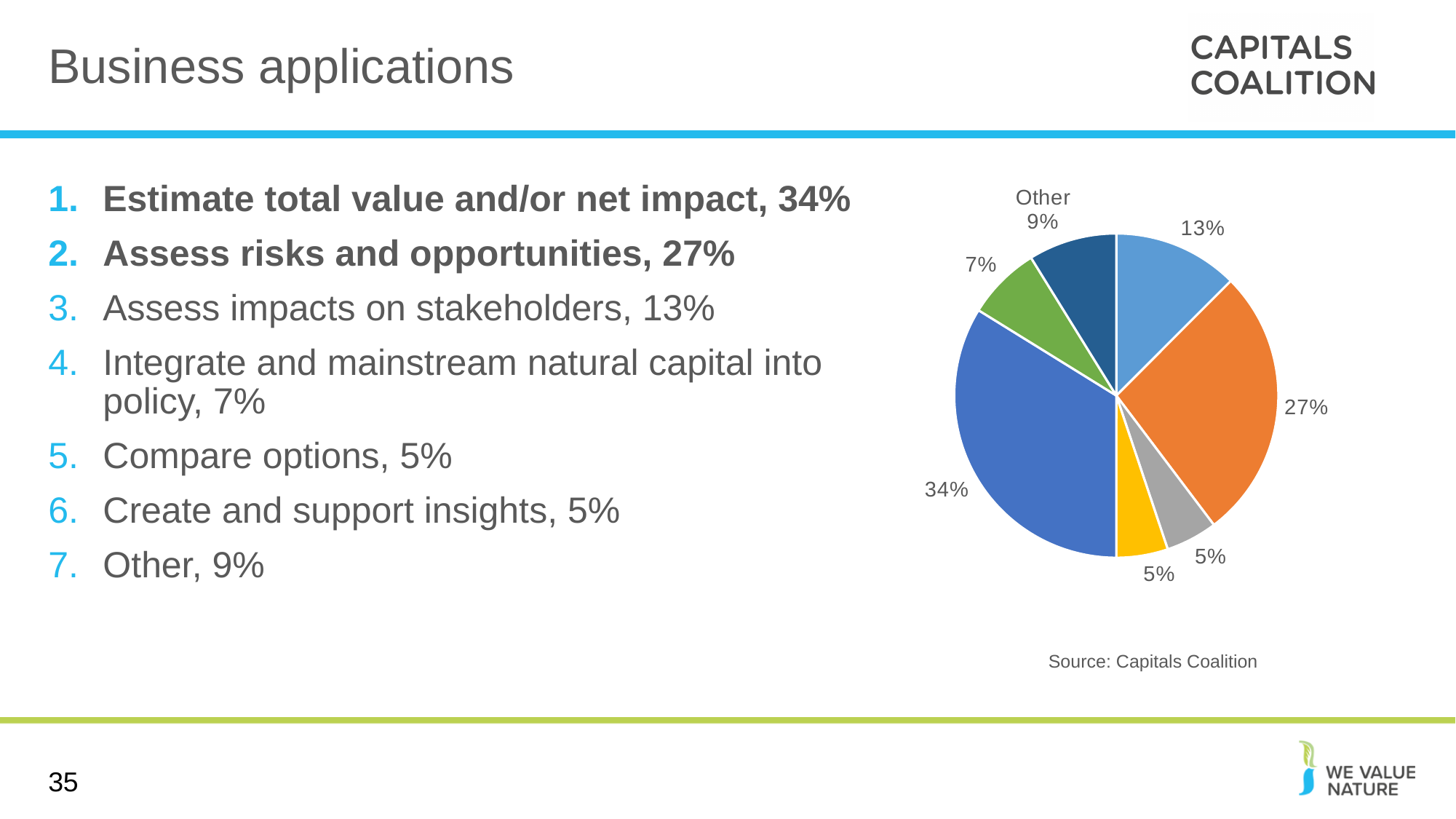
What share of the pie is labelled "Other"? 9% According to the slide, what share corresponds to "Estimate total value and/or net impact"? 34% What is the largest share shown in the pie chart? 34% Which is larger in the pie chart, the 13% slice or the 9% "Other" slice? the 13% slice How many slices does the pie chart have? 7 How many slices in the pie chart are labelled 5%? 2 What kind of chart is shown on the slide? pie chart What source is cited below the pie chart? Capitals Coalition What is the difference between the largest slice (34%) and the 27% slice? 7% What is the smallest share shown in the pie chart? 5% According to the slide, what share corresponds to "Assess risks and opportunities"? 27% According to the slide, what share corresponds to "Integrate and mainstream natural capital into policy"? 7%